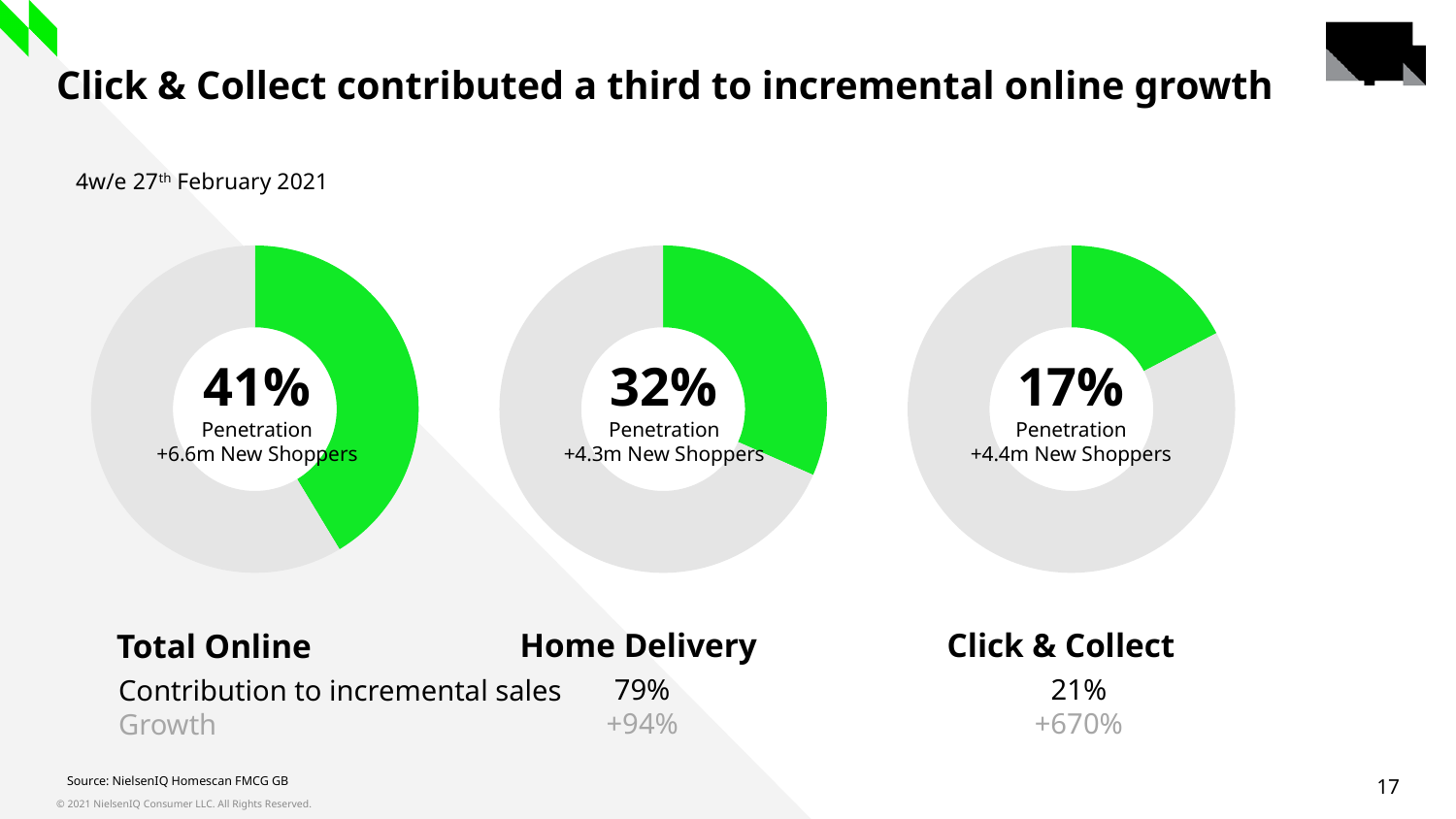
What is the penetration shown in the Click & Collect donut chart? 17% Which of the three donut charts shows the highest penetration? Total Online What is the difference in penetration between the Home Delivery and Click & Collect donut charts? 15% What is the penetration shown in the Home Delivery donut chart? 32% What kind of chart is used to show penetration on the slide? Donut chart Which of the three donut charts shows the lowest penetration? Click & Collect What colour is used for the penetration segment in the donut charts? Green How many new shoppers are shown in the Total Online donut chart? +6.6m New Shoppers How many donut charts are on the slide? 3 What is the penetration shown in the Total Online donut chart? 41% Which has the higher penetration, Home Delivery or Click & Collect? Home Delivery How many new shoppers are shown in the Click & Collect donut chart? +4.4m New Shoppers